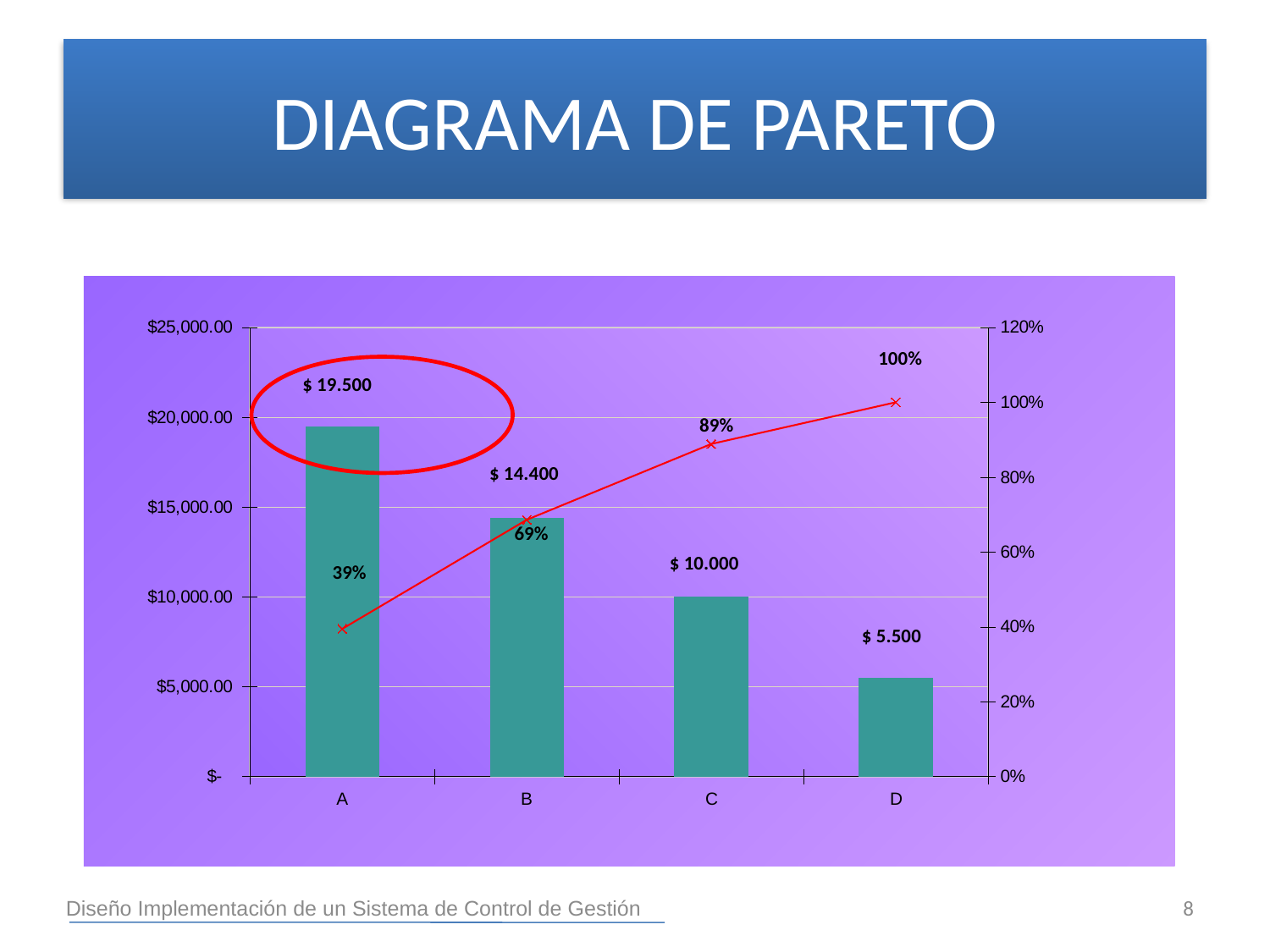
What is the title of the slide containing the chart? DIAGRAMA DE PARETO What is the difference between the bar values for A and B? $ 5.100 Which category has the lowest bar? D What is the value shown for category C? $ 10.000 How many categories are shown on the x axis? 4 Which category has the highest bar? A Which is larger, the bar value for B or for C? B What cumulative percentage is shown at category B? 69% What is the value shown for category A? $ 19.500 What is the difference between the cumulative percentages at C and B? 20% Do the bar values rise or fall from A to D? fall What cumulative percentage is shown at category D? 100%